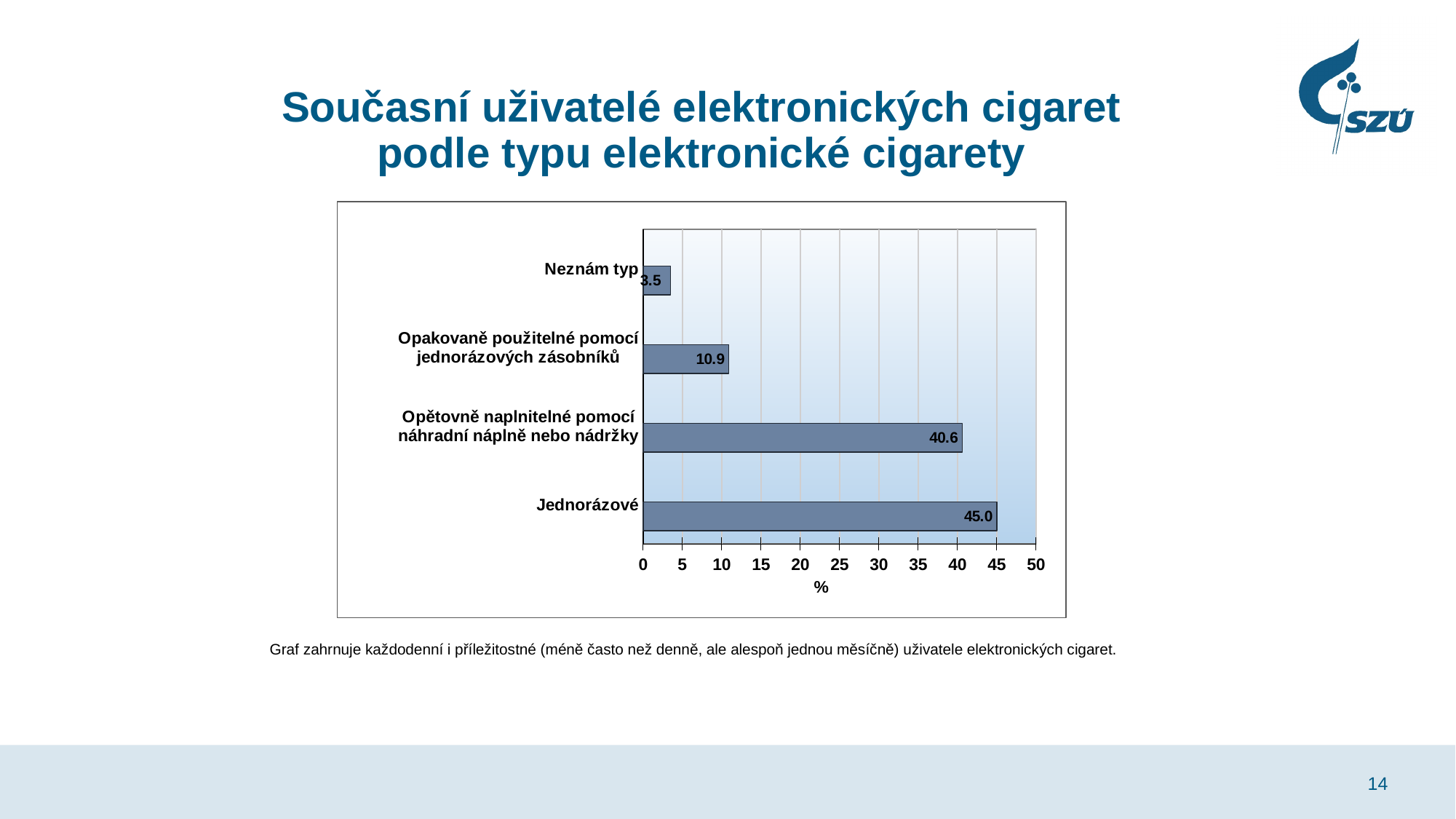
Is the value for Opětovně naplnitelné pomocí náhradní náplně nebo nádržky greater or less than 35? greater What unit is shown on the horizontal axis label? % What is the value for Neznám typ? 3.5 Which category has the highest value? Jednorázové What is the value for Opakovaně použitelné pomocí jednorázových zásobníků? 10.9 What is the difference between the values for Jednorázové and Opětovně naplnitelné pomocí náhradní náplně nebo nádržky? 4.4 What is the value for Opětovně naplnitelné pomocí náhradní náplně nebo nádržky? 40.6 What is the value for Jednorázové? 45.0 What kind of chart is shown on the slide? bar chart Which is larger: the value for Opakovaně použitelné pomocí jednorázových zásobníků or the value for Neznám typ? Opakovaně použitelné pomocí jednorázových zásobníků Which category has the lowest value? Neznám typ How many categories are shown in the chart? 4